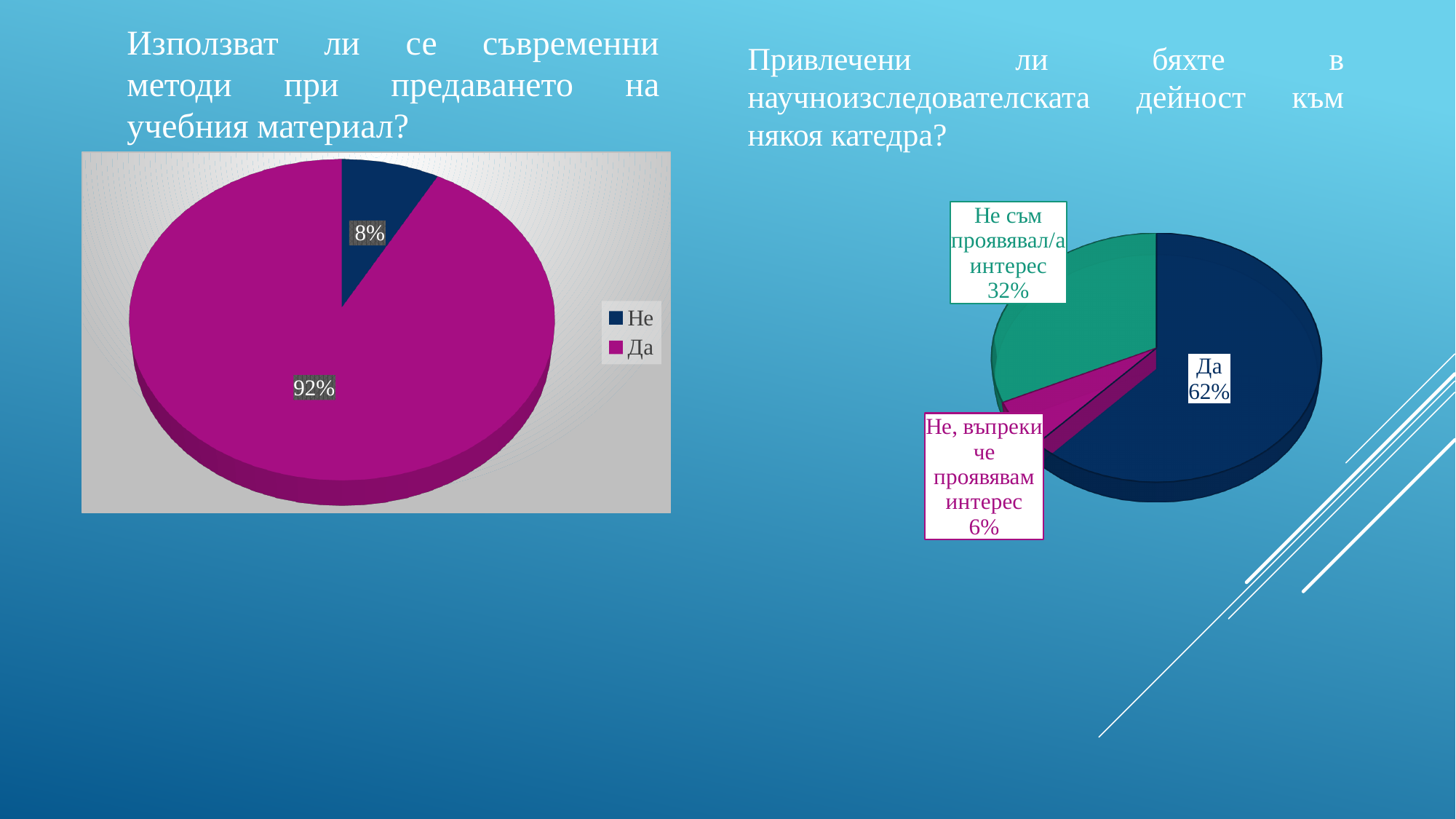
In the left pie chart (Използват ли се съвременни методи при предаването на учебния материал?), what is the difference in percentage points between Да and Не? 84 In the left pie chart (Използват ли се съвременни методи при предаването на учебния материал?), which category has the largest share? Да In the right pie chart (Привлечени ли бяхте в научноизследователската дейност към някоя катедра?), what percentage is shown for Не съм проявявал/а интерес? 32% In the left pie chart (Използват ли се съвременни методи при предаването на учебния материал?), what percentage is shown for Да? 92% In the right pie chart (Привлечени ли бяхте в научноизследователската дейност към някоя катедра?), what is the difference in percentage points between Да and Не съм проявявал/а интерес? 30 In the left pie chart (Използват ли се съвременни методи при предаването на учебния материал?), what percentage is shown for Не? 8% In the right pie chart (Привлечени ли бяхте в научноизследователската дейност към някоя катедра?), how many slices does the pie have? 3 In the right pie chart (Привлечени ли бяхте в научноизследователската дейност към някоя катедра?), what percentage is shown for Да? 62% In the left pie chart (Използват ли се съвременни методи при предаването на учебния материал?), how many entries does the legend list? 2 What kind of chart is the left chart (Използват ли се съвременни методи при предаването на учебния материал?)? pie chart In the right pie chart (Привлечени ли бяхте в научноизследователската дейност към някоя катедра?), what percentage is shown for Не, въпреки че проявявам интерес? 6% In the right pie chart (Привлечени ли бяхте в научноизследователската дейност към някоя катедра?), which category has the smallest share? Не, въпреки че проявявам интерес